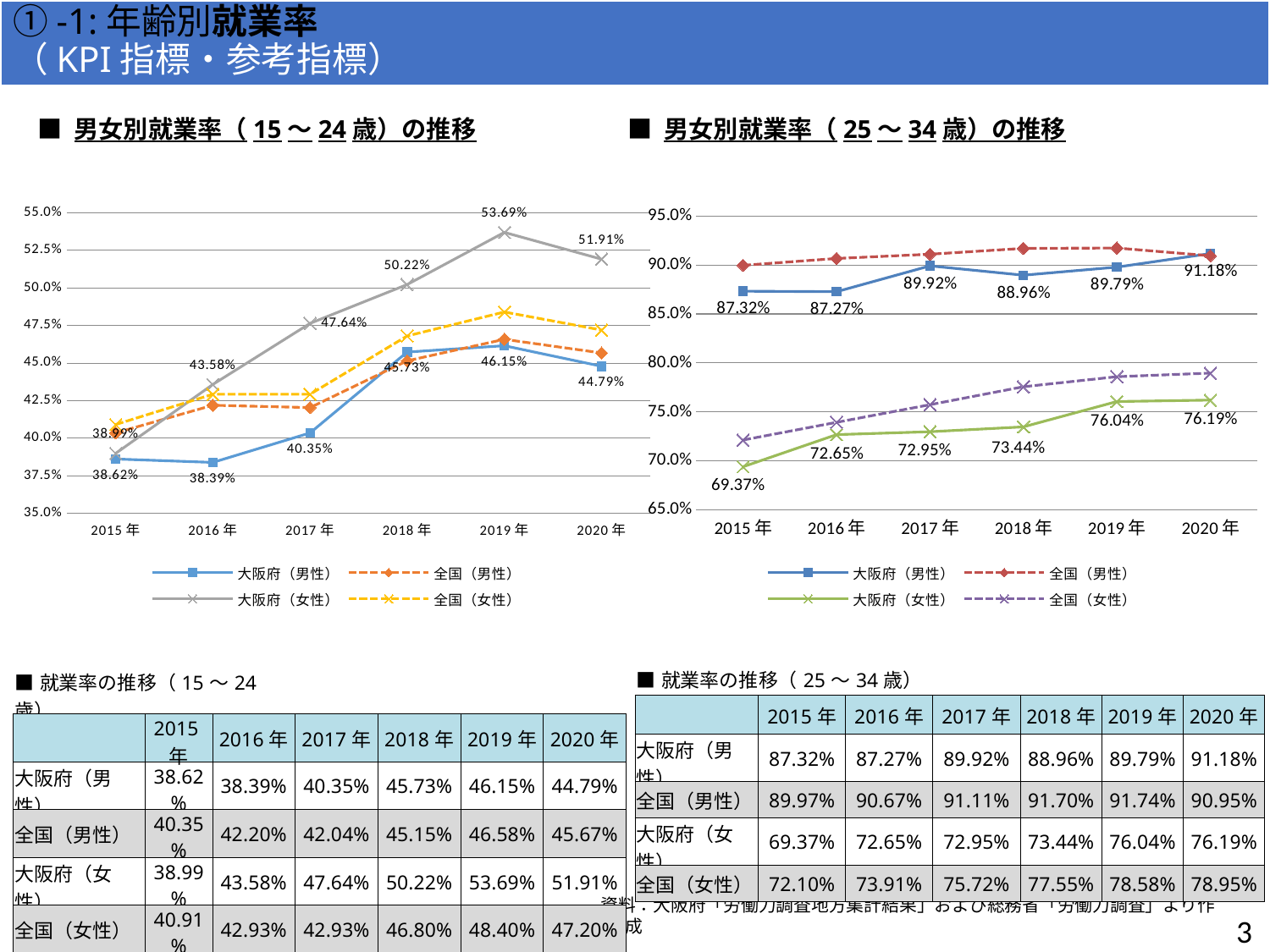
In the 男女別就業率（15～24歳）の推移 chart, what is the difference between the 大阪府（男性） values for 2019年 and 2020年? 1.36 percentage points In the 男女別就業率（15～24歳）の推移 chart, what is the value for 大阪府（女性） in 2019年? 53.69% In the 男女別就業率（25～34歳）の推移 chart, what is the value for 大阪府（男性） in 2020年? 91.18% In the 男女別就業率（25～34歳）の推移 chart, is the value for 全国（女性） in 2015年 greater or less than 75.0%? less In the 男女別就業率（25～34歳）の推移 chart, which is larger in 2018年: 大阪府（男性） or 大阪府（女性）? 大阪府（男性） In the 男女別就業率（25～34歳）の推移 chart, in which year is the 大阪府（女性） value lowest? 2015年 How many series does the legend of the 男女別就業率（15～24歳）の推移 chart list? 4 In the 男女別就業率（25～34歳）の推移 chart, does the 大阪府（女性） line rise or fall from 2015年 to 2020年? rises In the 男女別就業率（15～24歳）の推移 chart, in which year is the 大阪府（女性） value highest? 2019年 What kind of chart is the 男女別就業率（15～24歳）の推移 chart? line chart How many years are shown on the x axis of the 男女別就業率（25～34歳）の推移 chart? 6 In the 男女別就業率（15～24歳）の推移 chart, what is the value for 大阪府（男性） in 2017年? 40.35%